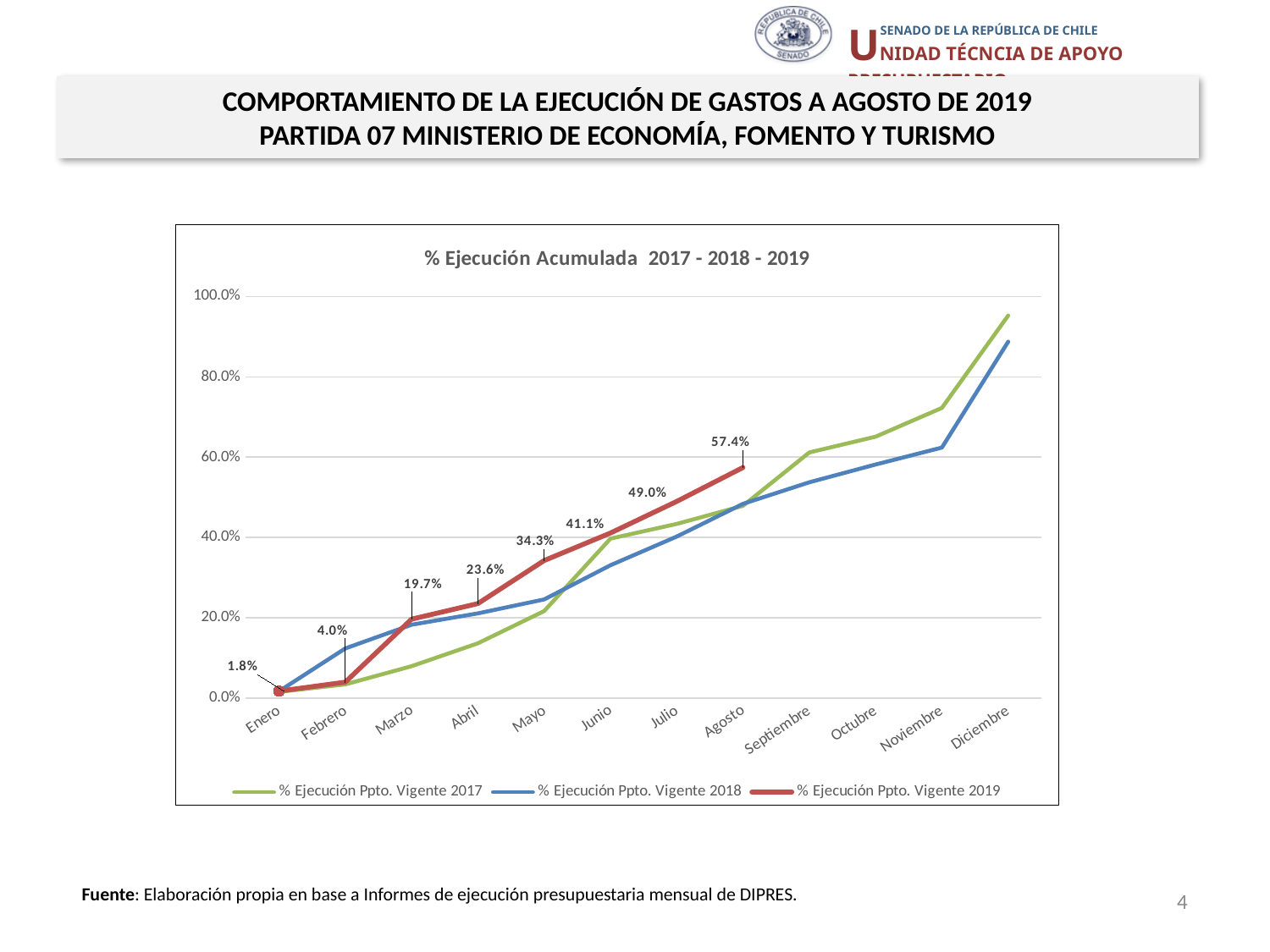
In Diciembre, which series has the higher value: % Ejecución Ppto. Vigente 2017 or % Ejecución Ppto. Vigente 2018? % Ejecución Ppto. Vigente 2017 How many series does the legend list? 3 What is the difference between the 2019 values for Mayo and Abril? 10.7 percentage points Does the % Ejecución Ppto. Vigente 2019 line rise or fall from Enero to Agosto? Rise What is the value of % Ejecución Ppto. Vigente 2019 for Agosto? 57.4% What is the value of % Ejecución Ppto. Vigente 2019 for Marzo? 19.7% What is the title of the chart? % Ejecución Acumulada 2017 - 2018 - 2019 Is the value for % Ejecución Ppto. Vigente 2017 in Diciembre greater or less than 80.0%? greater How many months are shown on the x axis? 12 What is the value of % Ejecución Ppto. Vigente 2019 for Enero? 1.8% By how many percentage points did % Ejecución Ppto. Vigente 2019 increase from Julio to Agosto? 8.4 percentage points What kind of chart is shown on the slide? Line chart